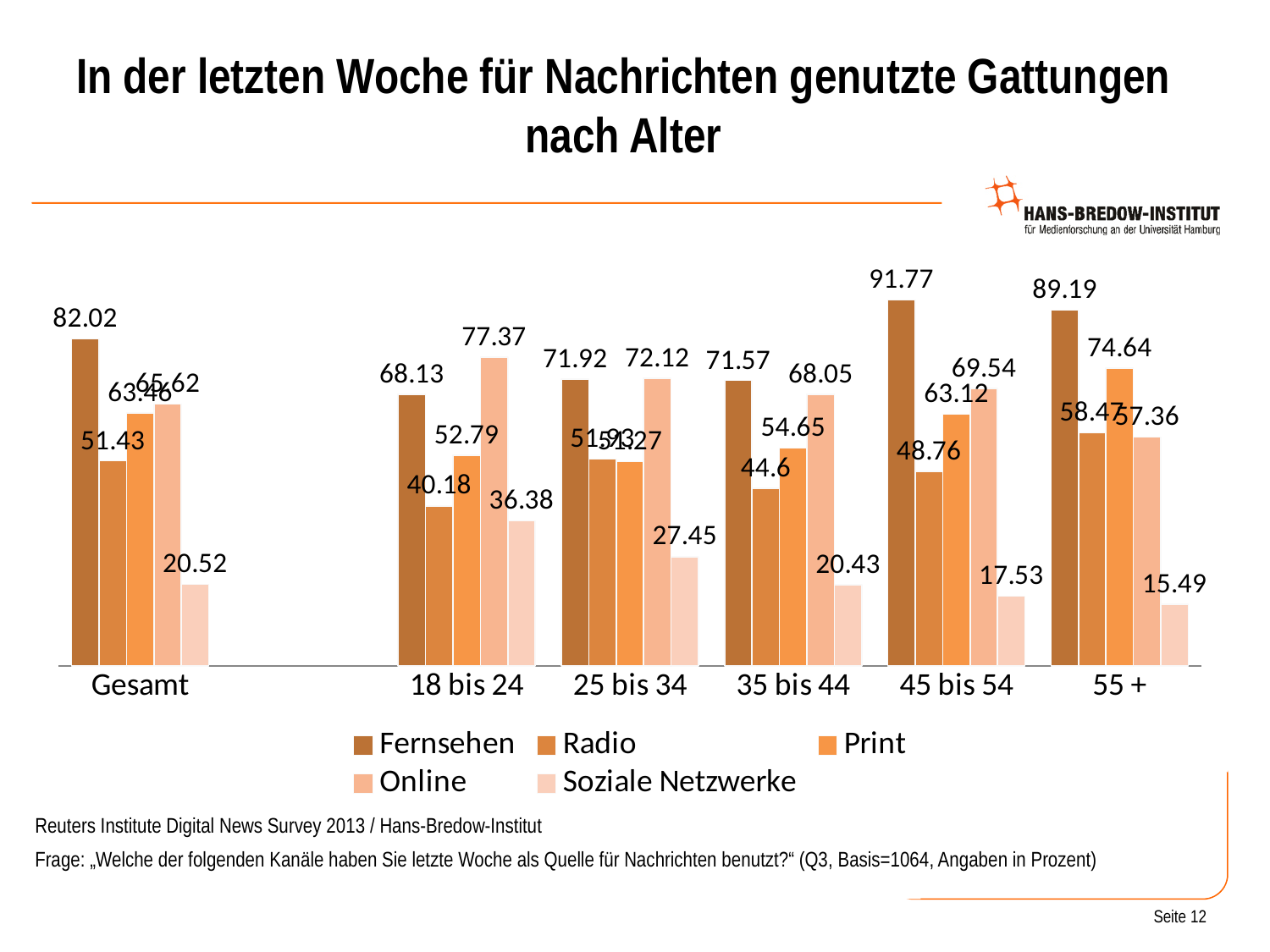
What is the value for Online in the 18 bis 24 age group? 77.37 How many categories are shown on the x axis? 6 What is the difference between the Fernsehen values for 45 bis 54 and 55 +? 2.58 What kind of chart is shown on the slide? Bar chart In the 18 bis 24 age group, which is larger: Online or Fernsehen? Online Do the Soziale Netzwerke values rise or fall from the 18 bis 24 group to the 55 + group? Fall What is the value for Fernsehen in the 45 bis 54 age group? 91.77 Which category has the lowest value for Soziale Netzwerke? 55 + What is the value for Soziale Netzwerke in the 18 bis 24 age group? 36.38 Which age group has the highest value for Fernsehen? 45 bis 54 How many series does the legend list? 5 What is the value for Radio in the 35 bis 44 age group? 44.6